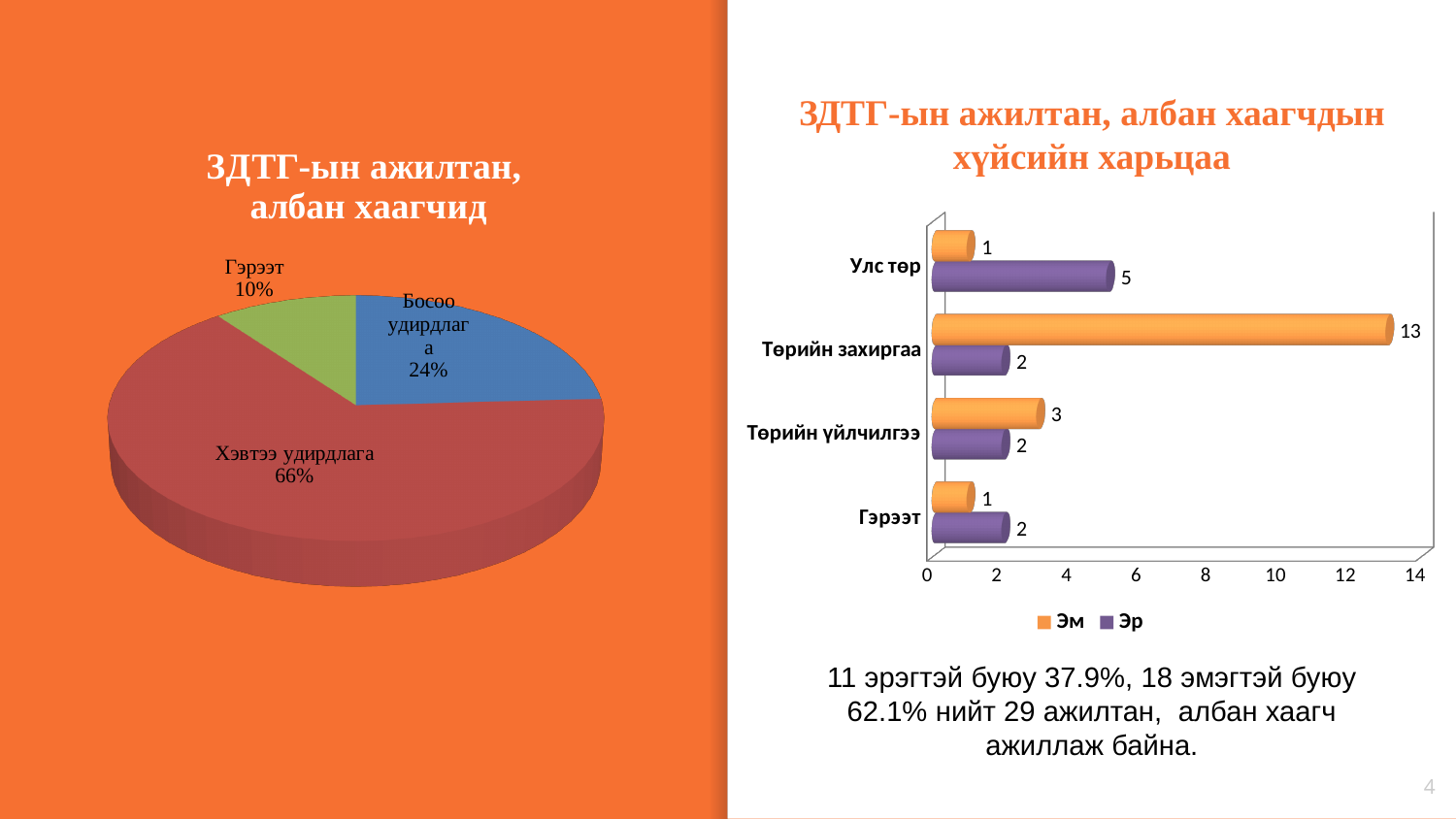
In the pie chart on the left, what share does Хэвтээ удирдлага have? 66% What kind of chart is the chart on the left? Pie chart In the bar chart on the right, what is the difference between Эм and Эр for Төрийн захиргаа? 11 In the bar chart on the right, how many series does the legend list? 2 In the bar chart on the right, what is the value of Эр for Улс төр? 5 In the pie chart on the left, which category has the smallest slice? Гэрээт In the pie chart on the left, what share does Гэрээт have? 10% In the pie chart on the left, how many slices are there? 3 In the bar chart on the right, which category has the highest Эм value? Төрийн захиргаа In the bar chart on the right, which is larger for Улс төр, Эм or Эр? Эр In the bar chart on the right, how many categories are shown? 4 In the bar chart on the right, what is the value of Эм for Төрийн захиргаа? 13